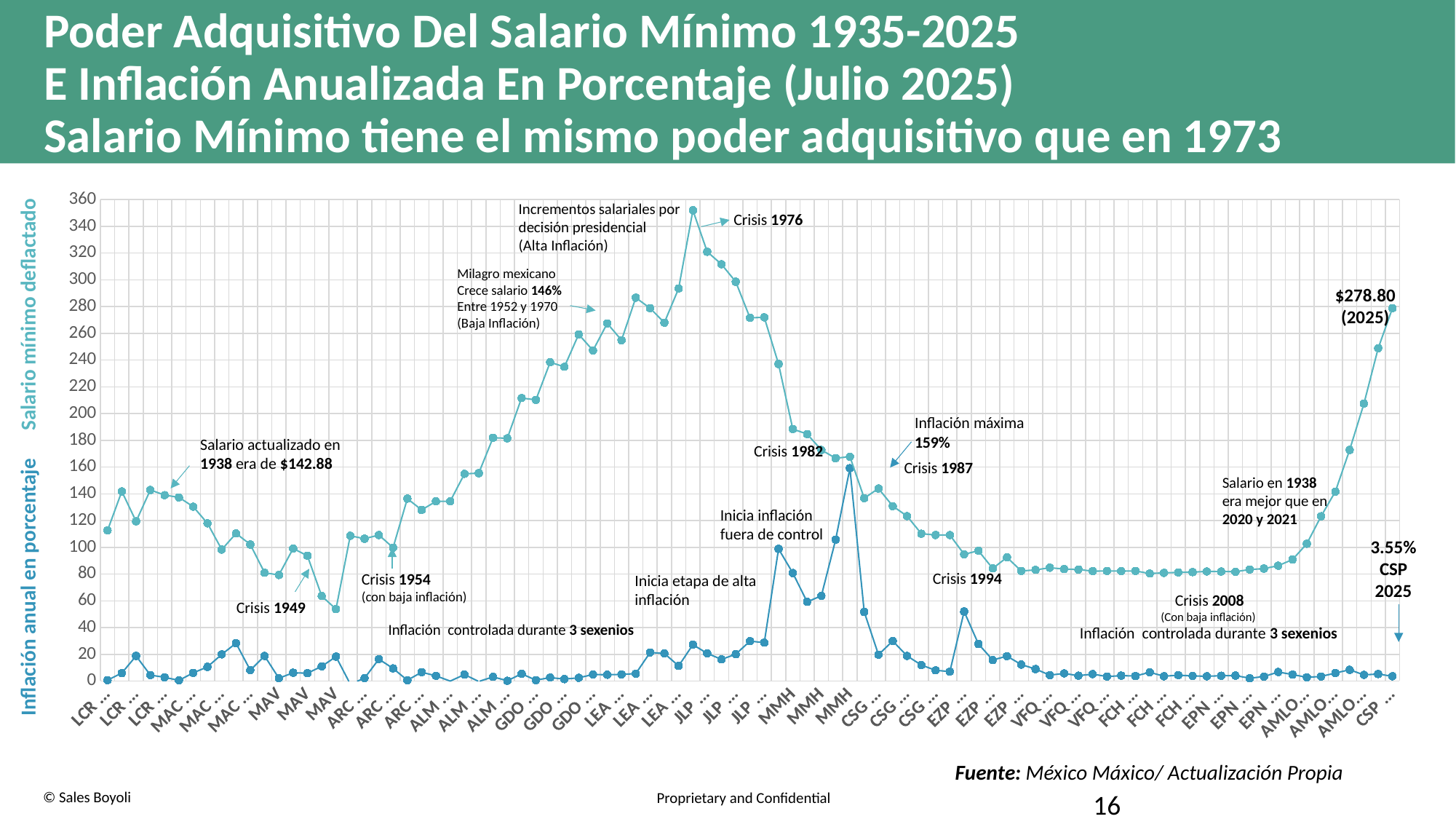
In which year does the deflated minimum wage reach its highest point on the chart? 1976 What annual inflation percentage is shown for CSP 2025? 3.55% By what percentage did the salary grow between 1952 and 1970 according to the annotation? 146% What is the deflated minimum wage value shown for 2025? $278.80 What is the difference between the 2025 deflated minimum wage ($278.80) and the 1938 salary ($142.88)? $135.92 Is the deflated minimum wage during the VFQ period greater or less than 100? less Is the peak value of the deflated minimum wage in 1976 greater or less than 340? greater Which is larger, the deflated minimum wage in 2025 or the salary in 1938? 2025 What kind of chart is shown on the slide? line chart Does the deflated minimum wage rise or fall from the AMLO period to the CSP period? rise What is the maximum inflation value annotated on the chart? 159% According to the annotation, what was the updated salary in 1938? $142.88